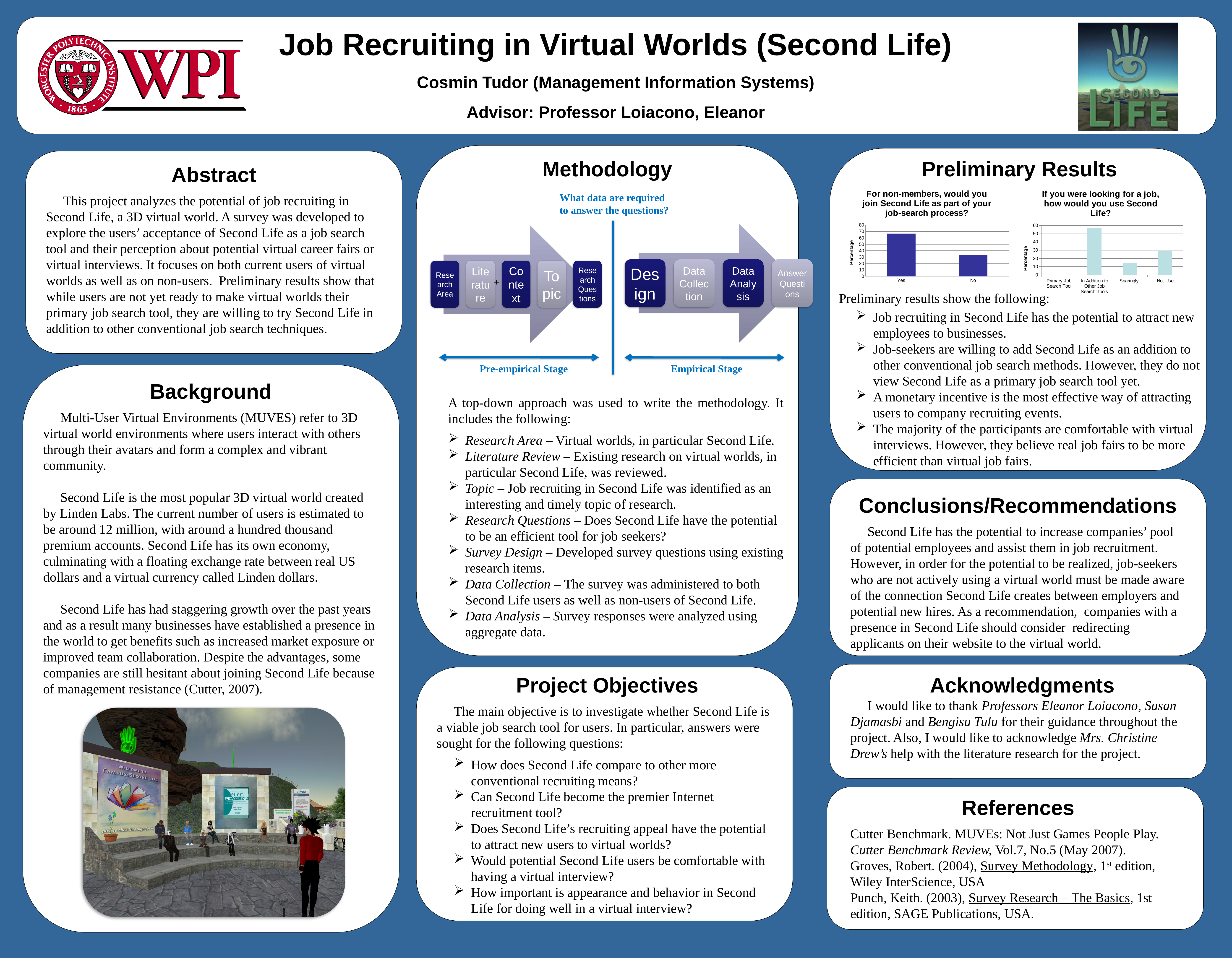
In the chart titled "If you were looking for a job, how would you use Second Life?", is the value for Sparingly greater or less than 20? less In the chart titled "For non-members, would you join Second Life as part of your job-search process?", which category has the higher value? Yes How many categories are shown in the chart titled "If you were looking for a job, how would you use Second Life?"? 4 In the chart titled "For non-members, would you join Second Life as part of your job-search process?", is the value for No greater or less than 40? less In the chart titled "If you were looking for a job, how would you use Second Life?", which category has the highest value? In Addition to Other Job Search Tools What is the y-axis label of the chart titled "If you were looking for a job, how would you use Second Life?"? Percentage In the chart titled "For non-members, would you join Second Life as part of your job-search process?", is the value for Yes greater or less than 60? greater What kind of chart is the one titled "For non-members, would you join Second Life as part of your job-search process?"? bar chart How many categories are shown in the chart titled "For non-members, would you join Second Life as part of your job-search process?"? 2 In the chart titled "If you were looking for a job, how would you use Second Life?", which is larger: Not Use or Sparingly? Not Use In the chart titled "If you were looking for a job, how would you use Second Life?", which category has the lowest value? Primary Job Search Tool